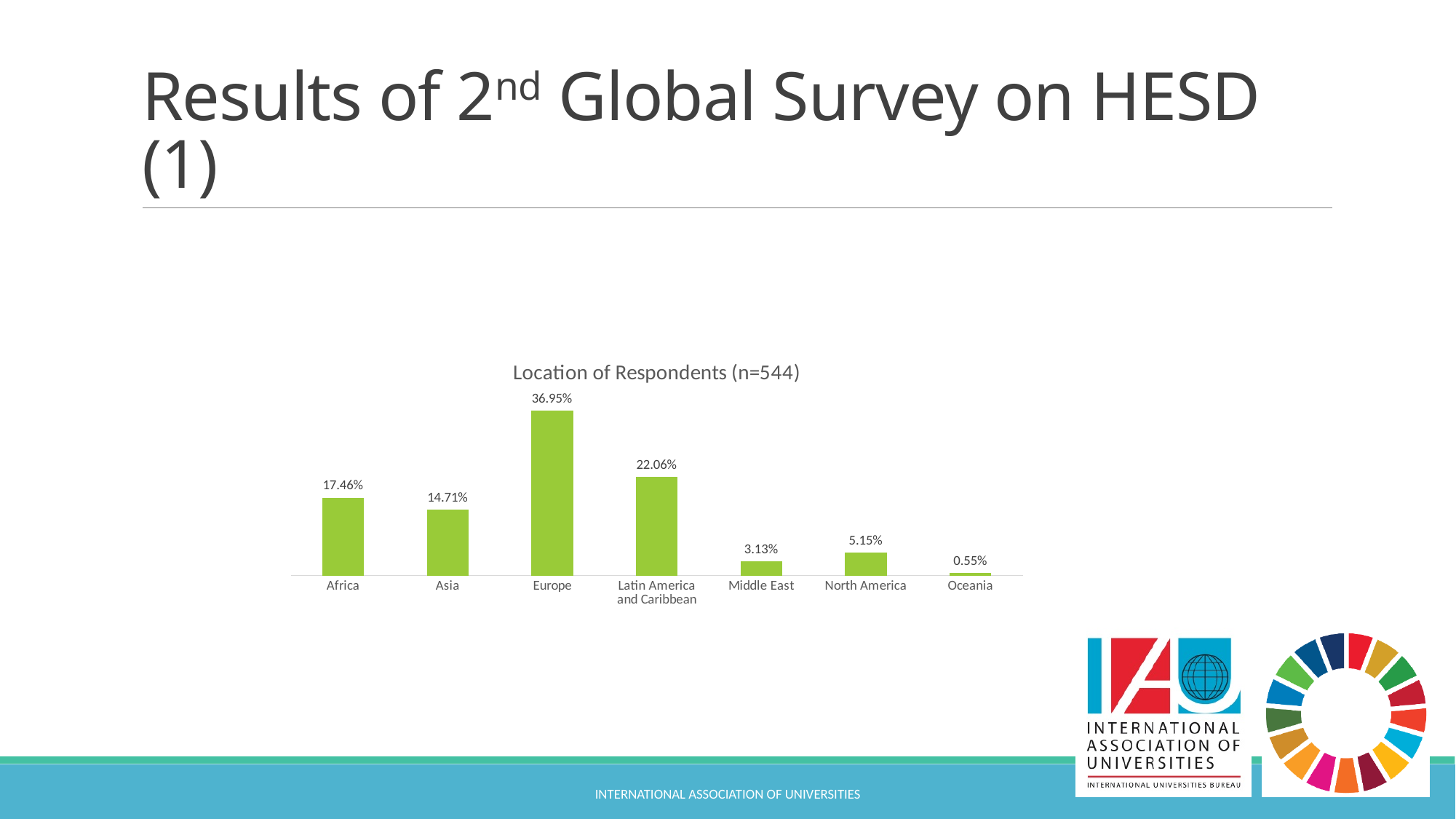
What is the title of the chart? Location of Respondents (n=544) What percentage of respondents are from Oceania? 0.55% What is the difference between the values for Africa and Asia? 2.75% What kind of chart is shown on the slide? Bar chart Which location has the lowest share of respondents? Oceania What is the difference between the values for Europe and Latin America and Caribbean? 14.89% Which has a larger value, Middle East or North America? North America Which location has the highest share of respondents? Europe How many locations are shown on the chart? 7 What percentage of respondents are located in Europe? 36.95% What is the value for North America? 5.15% What is the value shown for Latin America and Caribbean? 22.06%